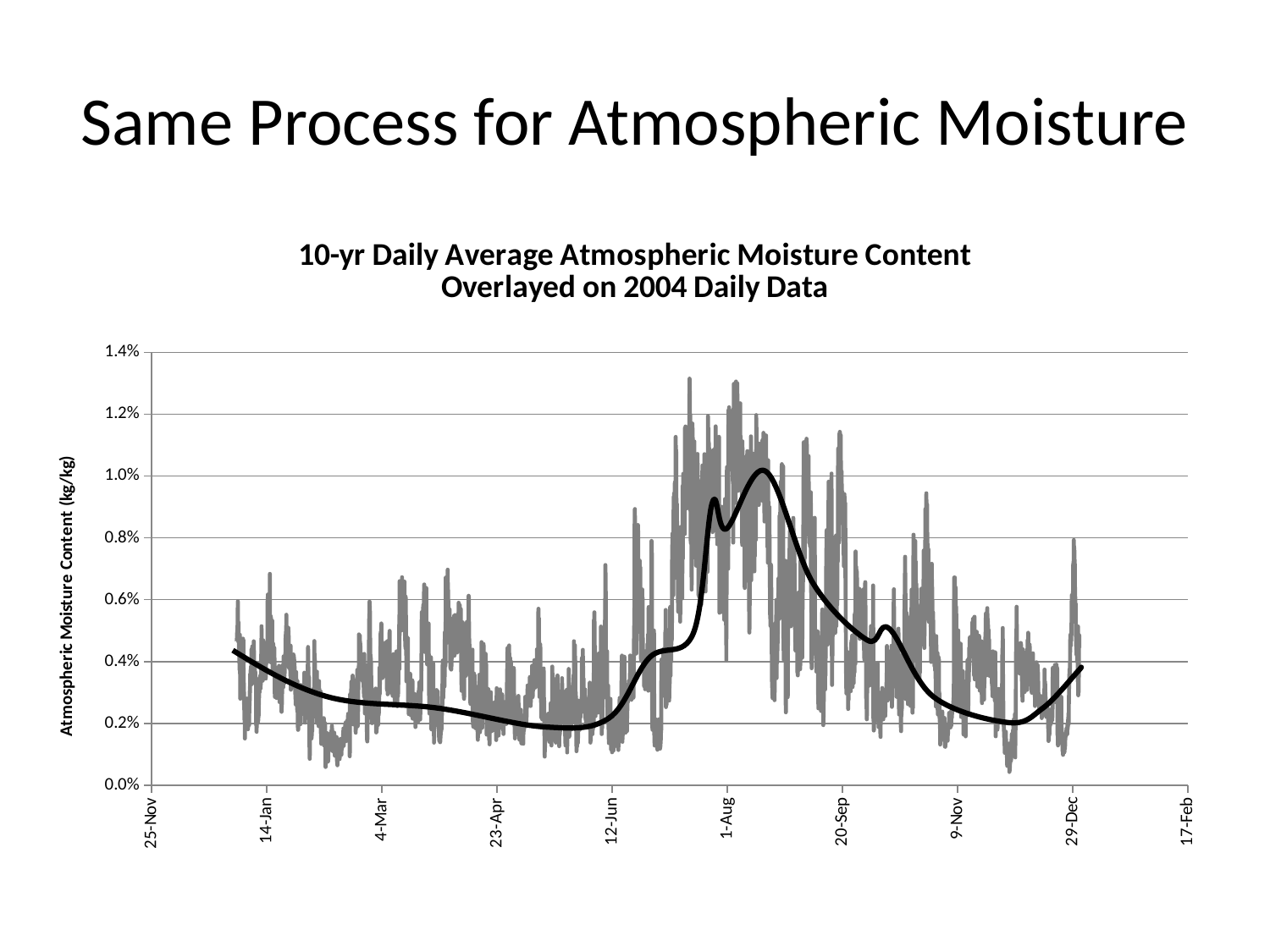
Is the peak of the smooth black 10-yr average line greater or less than 0.8%? greater Does the smooth black line rise or fall between 1-Aug and 9-Nov? fall What is the highest value shown on the vertical axis? 1.4% Is the value of the smooth black line at 4-Mar greater or less than 0.4%? less In which month does the smooth black 10-yr average line reach its highest value? August What is the title of the chart? 10-yr Daily Average Atmospheric Moisture Content Overlayed on 2004 Daily Data What kind of chart is shown on the slide? Line chart Is the highest spike of the grey 2004 daily data greater or less than 1.2%? greater What is the label on the vertical axis of the chart? Atmospheric Moisture Content (kg/kg) Does the smooth black line rise or fall between 12-Jun and 1-Aug? rise